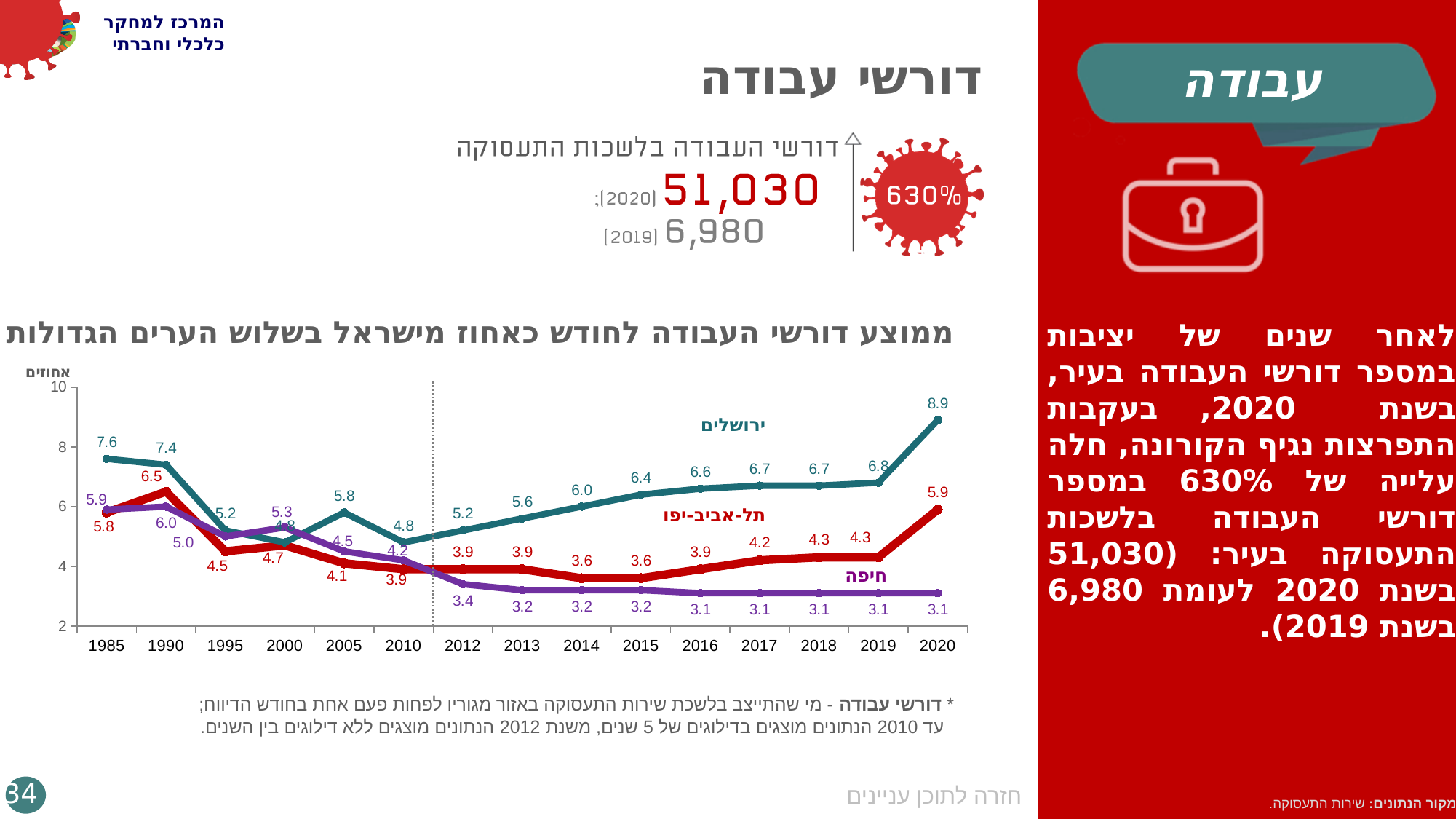
What is the label of the y axis of the chart? אחוזים How many years are shown on the x axis of the chart? 15 Does the value for חיפה rise or fall from 2012 to 2016? fall What is the value for חיפה (Haifa) in 2012? 3.4 What is the value for ירושלים (Jerusalem) in 2020? 8.9 What is the difference between the ירושלים value in 2020 and its value in 2019? 2.1 Which city has the lowest value in 2016? חיפה What is the value for תל-אביב-יפו (Tel Aviv-Yafo) in 2019? 4.3 Which is larger in 1990: the value for תל-אביב-יפו or the value for חיפה? תל-אביב-יפו Which city has the highest value in 2020? ירושלים What type of chart is shown on the slide? line chart How many series (cities) are plotted in the chart? 3